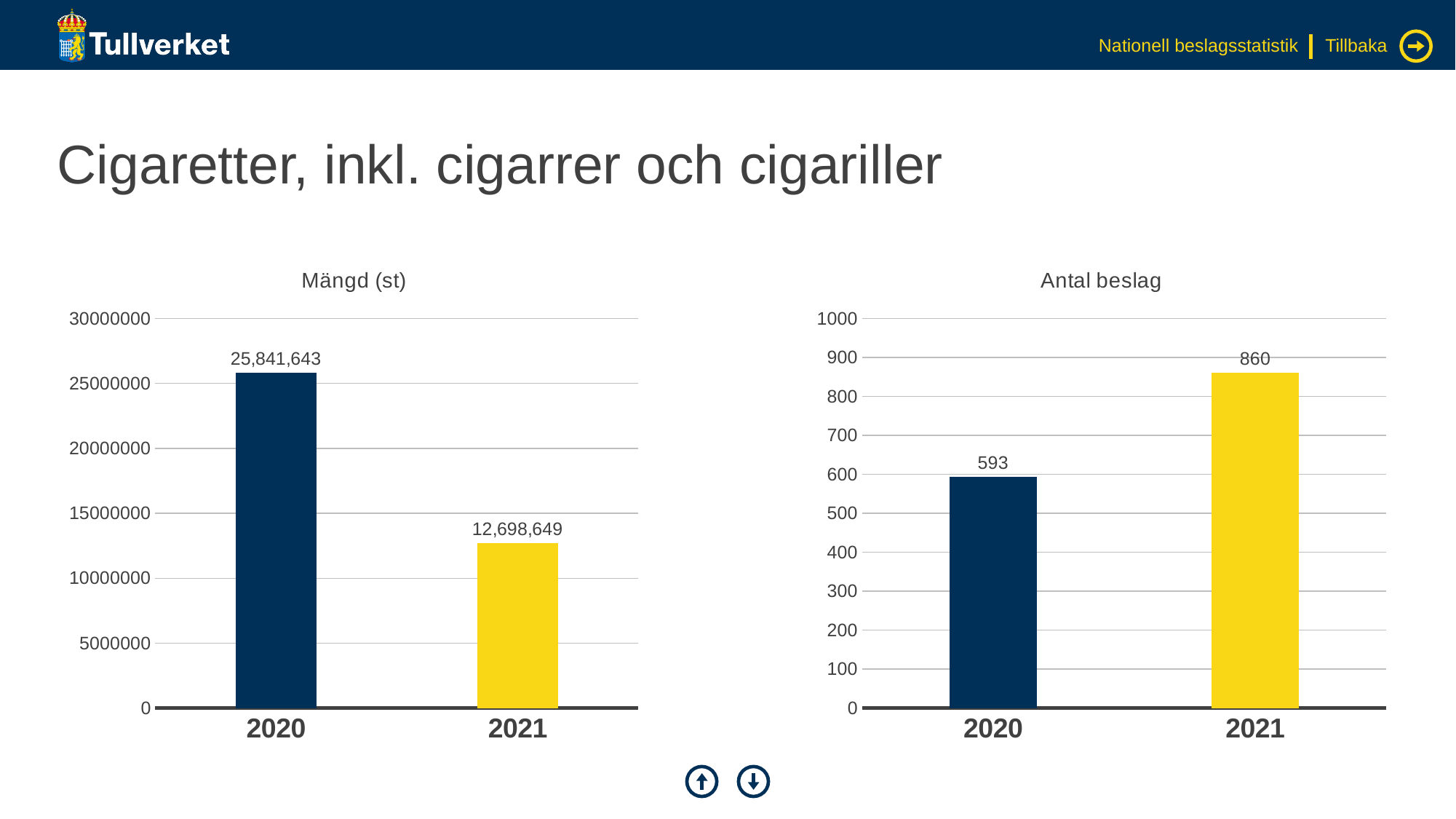
What kind of chart is the 'Antal beslag' chart? bar chart In the 'Antal beslag' chart, what is the value for 2021? 860 In the 'Mängd (st)' chart, what is the value for 2020? 25,841,643 In the 'Mängd (st)' chart, what is the value for 2021? 12,698,649 In the 'Mängd (st)' chart, which year has the highest value? 2020 In the 'Mängd (st)' chart, what is the difference between the 2020 and 2021 values? 13,143,994 In the 'Mängd (st)' chart, how many years are shown on the x axis? 2 In the 'Antal beslag' chart, is the value for 2021 greater or less than 800? greater In the 'Antal beslag' chart, what is the value for 2020? 593 In the 'Antal beslag' chart, what is the difference between the 2021 and 2020 values? 267 In the 'Antal beslag' chart, which year has the lowest value? 2020 In the 'Antal beslag' chart, do the values rise or fall from 2020 to 2021? rise